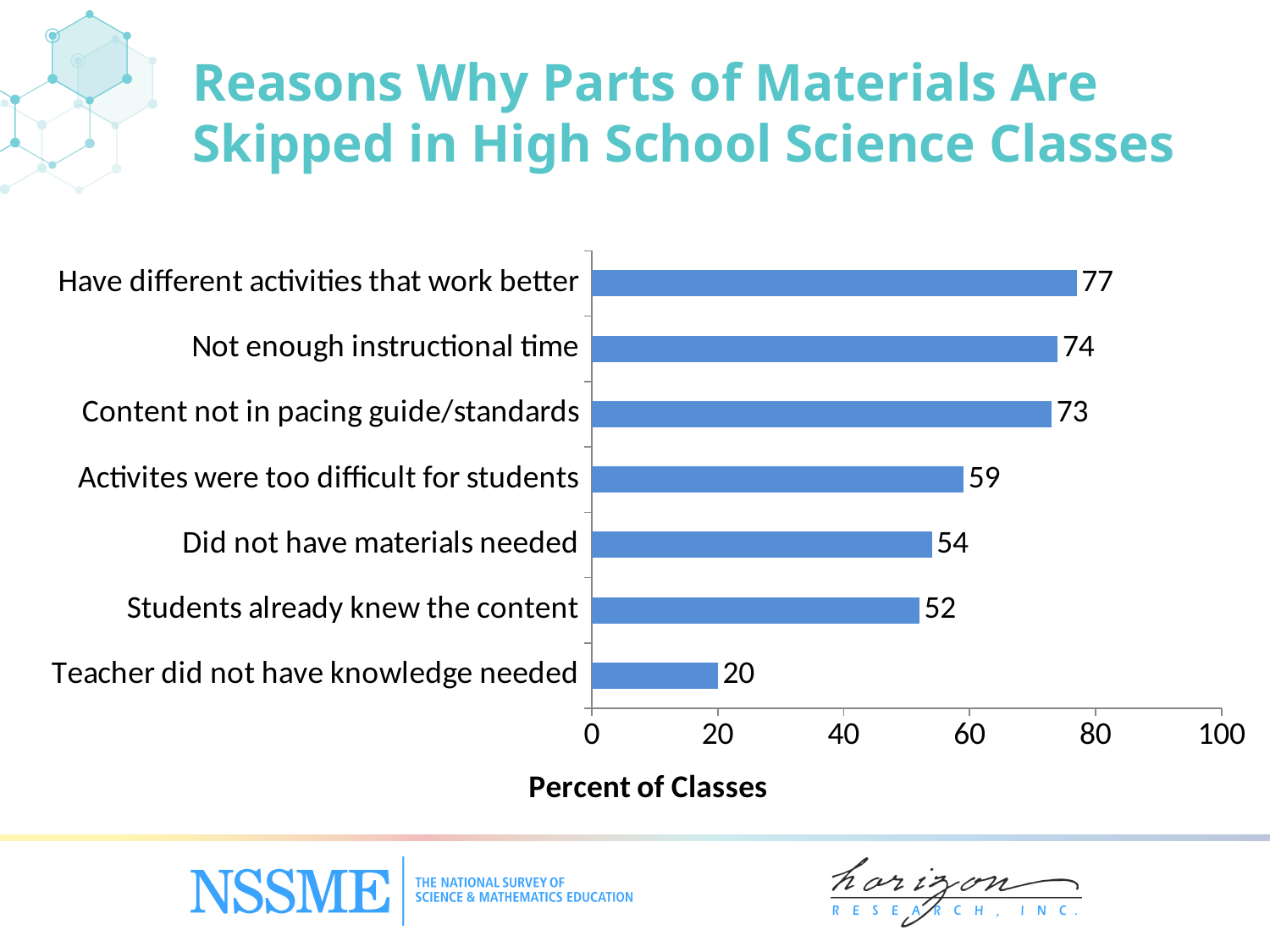
Is the value for "Did not have materials needed" greater or less than 60? less What is the label of the horizontal axis? Percent of Classes Which reason has the lowest percent of classes? Teacher did not have knowledge needed What is the value for "Not enough instructional time"? 74 Which is larger: "Content not in pacing guide/standards" or "Students already knew the content"? Content not in pacing guide/standards What is the difference between the highest and lowest values on the chart? 57 What percent of classes skipped parts of materials because they have different activities that work better? 77 What is the difference between "Activites were too difficult for students" and "Did not have materials needed"? 5 What is the value for "Teacher did not have knowledge needed"? 20 What kind of chart is shown on the slide? Bar chart Which reason has the highest percent of classes? Have different activities that work better How many reasons are shown on the chart? 7